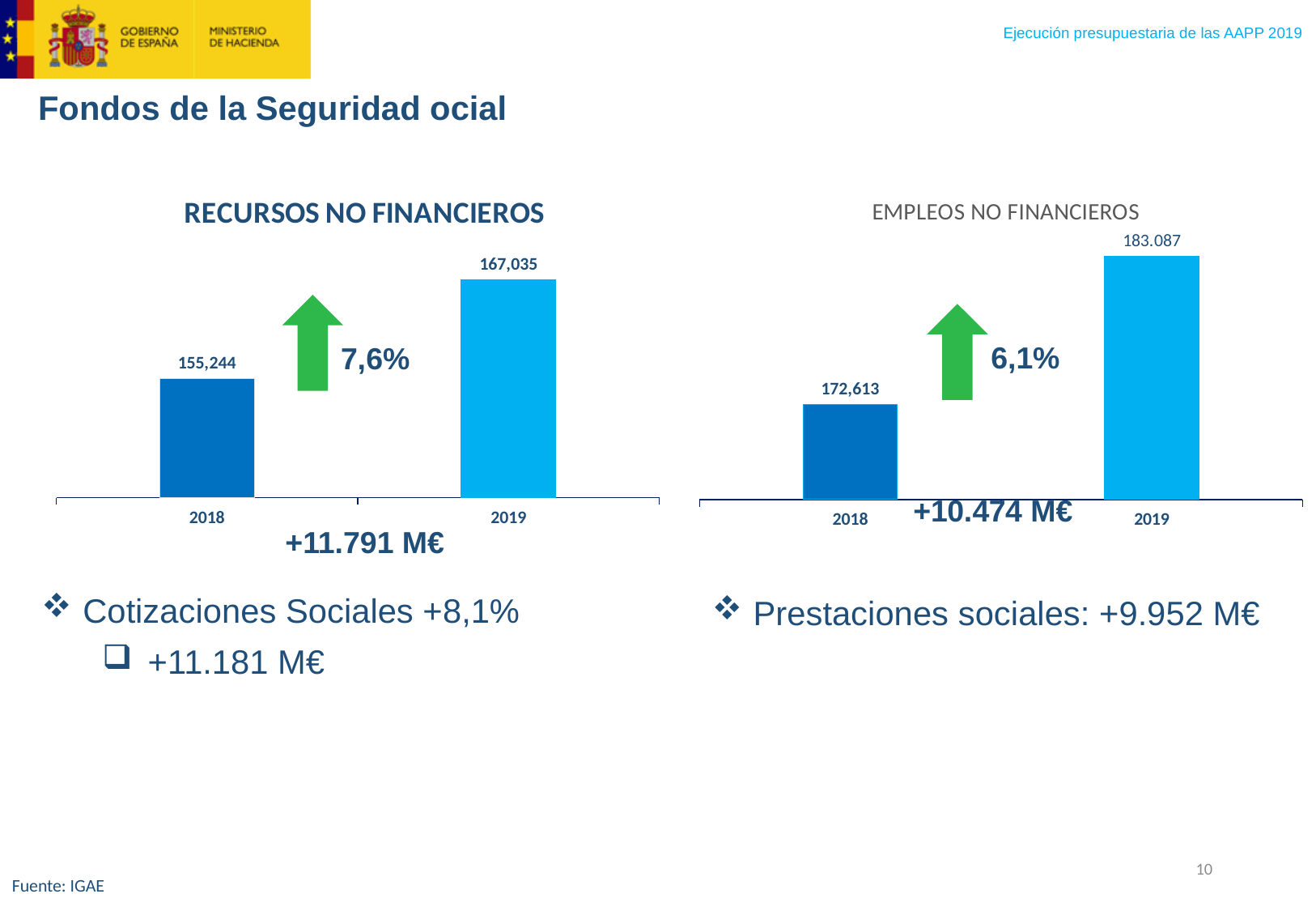
In the EMPLEOS NO FINANCIEROS chart, what is the value for 2018? 172,613 In the RECURSOS NO FINANCIEROS chart, what is the difference between the 2019 and 2018 values? 11,791 In the RECURSOS NO FINANCIEROS chart, do the values rise or fall from 2018 to 2019? rise In the RECURSOS NO FINANCIEROS chart, what is the value for 2019? 167,035 In the EMPLEOS NO FINANCIEROS chart, what is the value for 2019? 183.087 In the RECURSOS NO FINANCIEROS chart, what is the value for 2018? 155,244 How many years are shown in the RECURSOS NO FINANCIEROS chart? 2 What type of chart is the EMPLEOS NO FINANCIEROS chart? bar chart In the RECURSOS NO FINANCIEROS chart, which year has the higher value? 2019 In the EMPLEOS NO FINANCIEROS chart, which year has the lower value? 2018 In the EMPLEOS NO FINANCIEROS chart, what is the difference between the 2019 and 2018 values? 10,474 In the EMPLEOS NO FINANCIEROS chart, is the value for 2019 larger or smaller than the value for 2018? larger